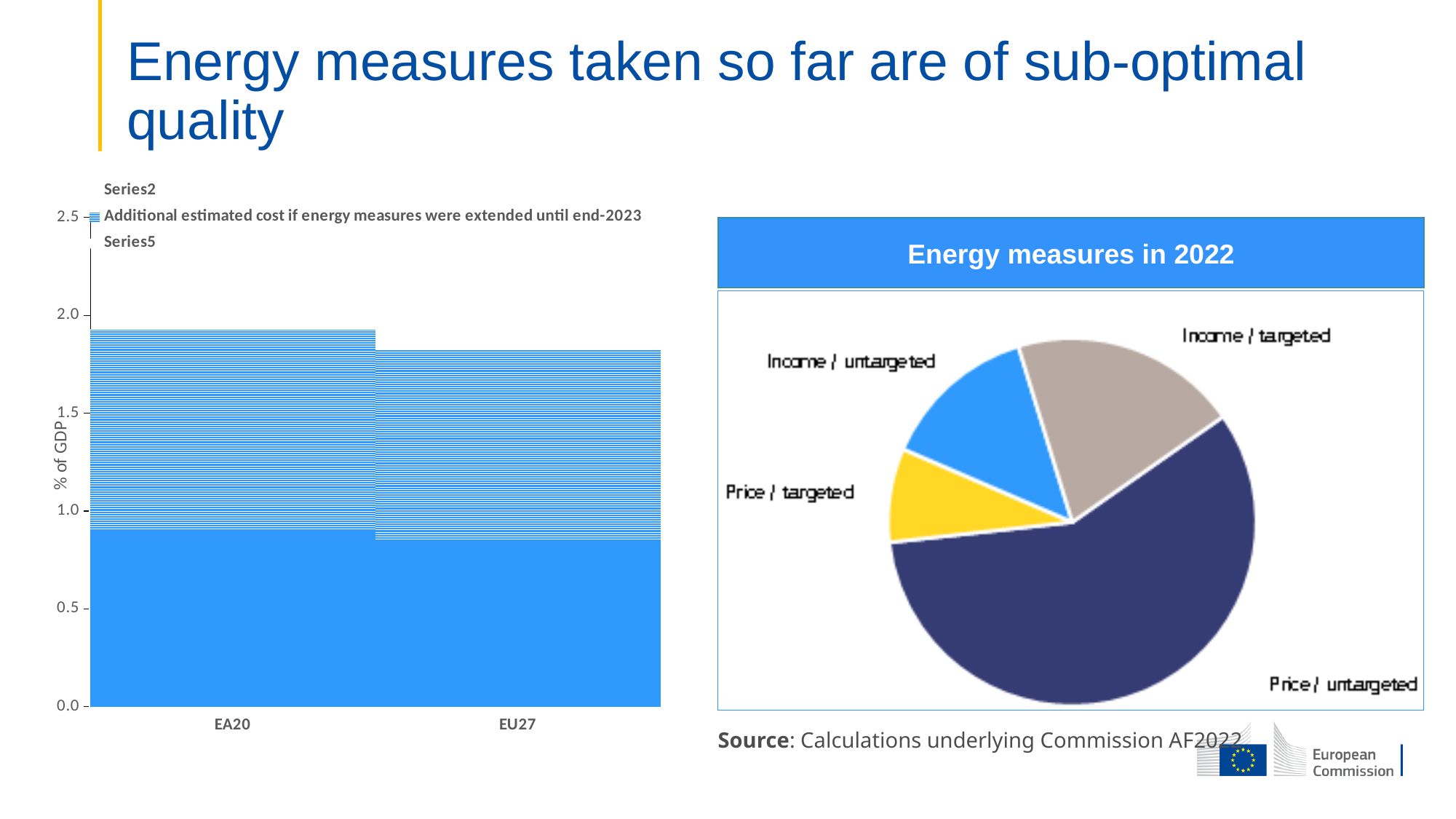
In the pie chart titled "Energy measures in 2022", how many slices are there? 4 In the bar chart on the left, how many categories are shown on the x axis? 2 What kind of chart is the chart titled "Energy measures in 2022"? pie chart In the pie chart titled "Energy measures in 2022", which slice is larger, Income / targeted or Income / untargeted? Income / targeted In the bar chart on the left, is the total height of the EA20 bar greater or less than 1.5? greater In the bar chart on the left, how many series does the legend list? 3 In the bar chart on the left, what is the label of the y axis? % of GDP In the bar chart on the left, which category has the taller stacked bar, EA20 or EU27? EA20 In the bar chart on the left, is the total height of the EU27 bar greater or less than 2.0? less What kind of chart is the chart on the left of the slide? bar chart In the pie chart titled "Energy measures in 2022", which slice is the largest? Price / untargeted In the pie chart titled "Energy measures in 2022", which slice is the smallest? Price / targeted